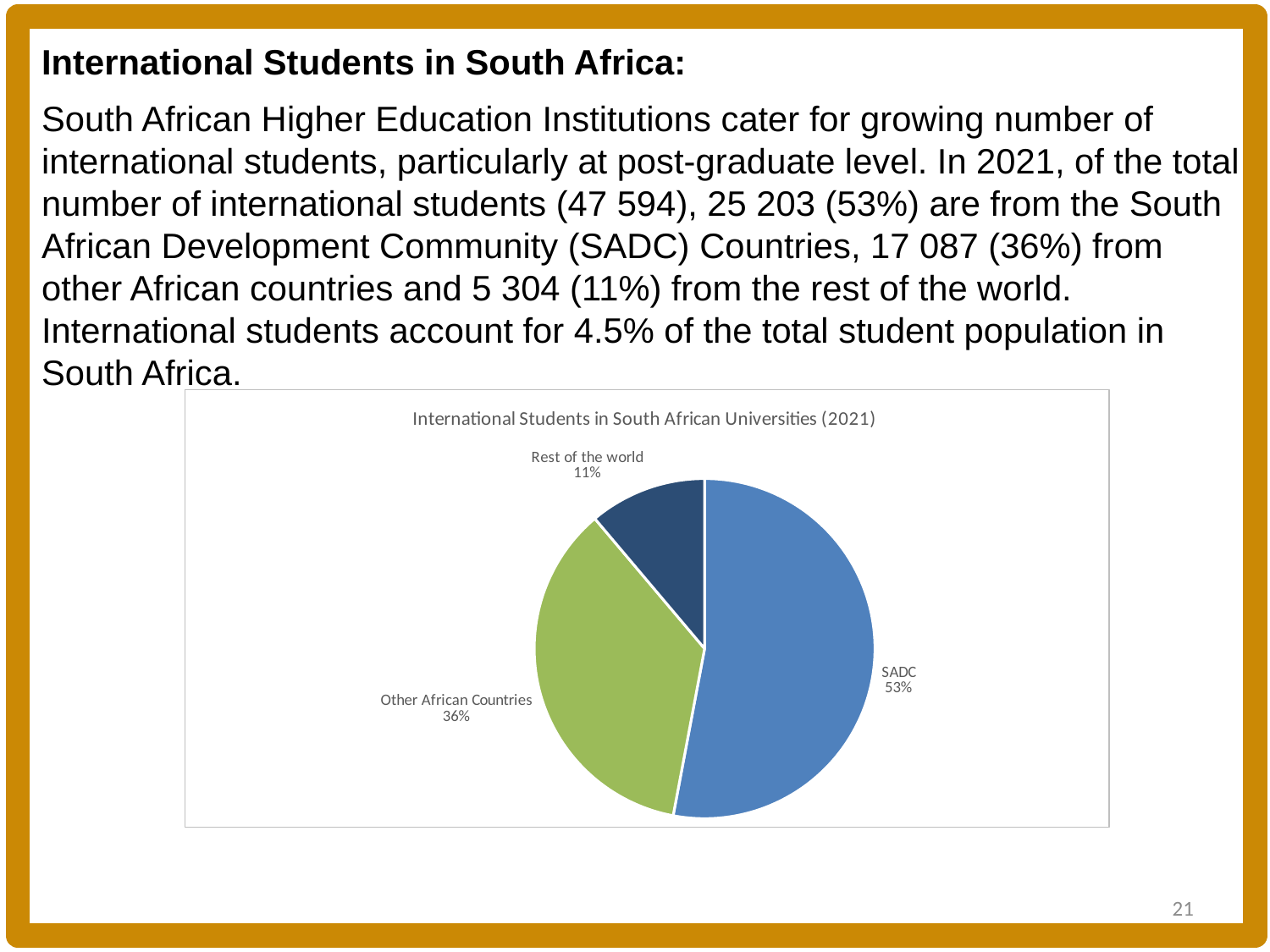
What is the title of the chart? International Students in South African Universities (2021) What is the difference in percentage points between the SADC slice and the Other African Countries slice? 17 Which slice of the pie is the largest? SADC What share of the pie does SADC account for? 53% Which is larger, the Other African Countries slice or the Rest of the world slice? Other African Countries How many slices does the pie chart have? 3 What colour is the SADC slice? blue Which slice of the pie is the smallest? Rest of the world What share of the pie does Other African Countries account for? 36% What is the difference in percentage points between the Other African Countries slice and the Rest of the world slice? 25 What kind of chart is shown on the slide? pie chart What share of the pie does Rest of the world account for? 11%